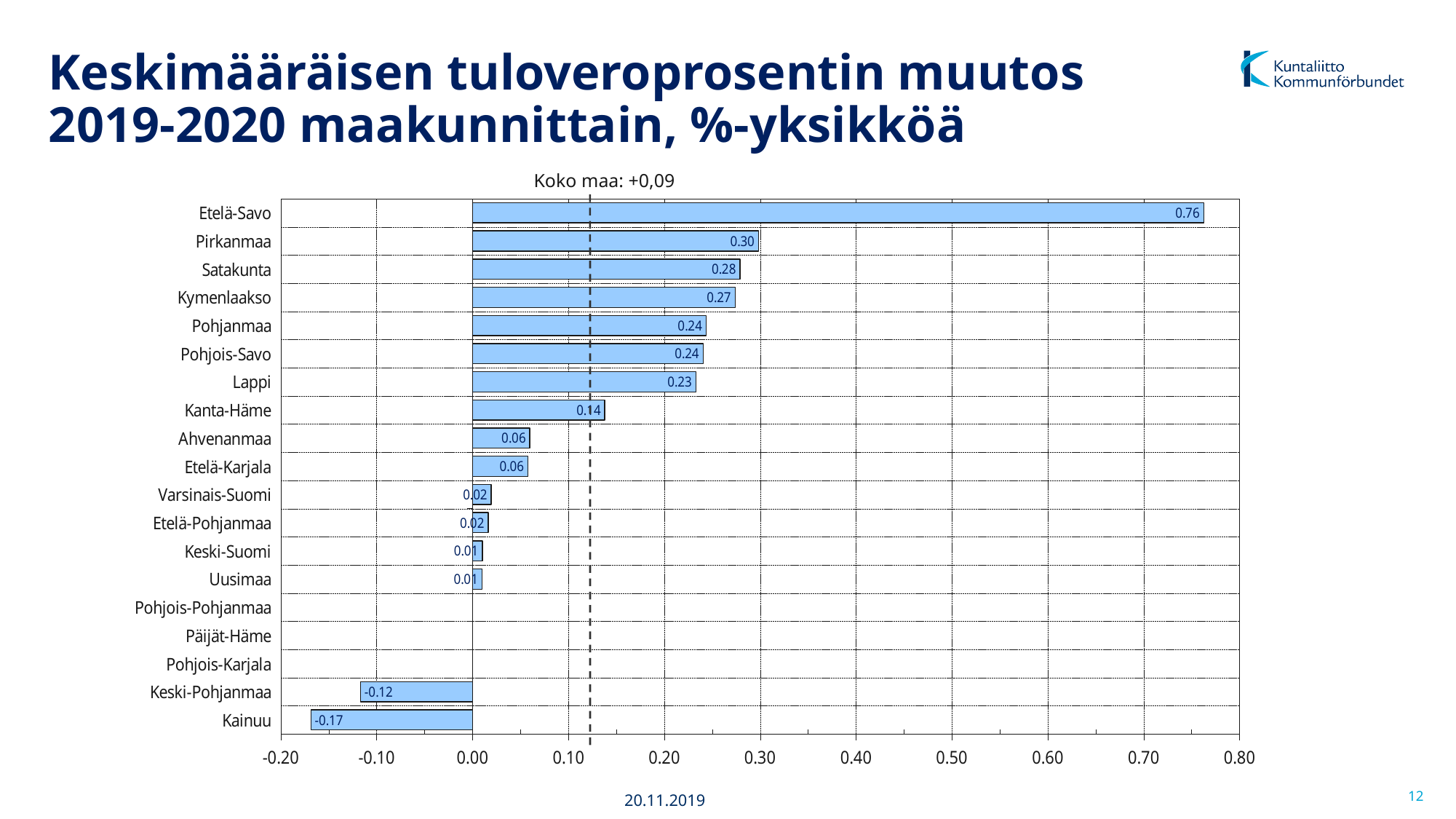
What is the value for Pirkanmaa? 0.30 What is the value for Kainuu? -0.17 What is the value for Keski-Pohjanmaa? -0.12 Is the value for Kymenlaakso greater or less than 0.20? greater What is the difference between the values for Etelä-Savo and Pirkanmaa? 0.46 Which region has the highest value? Etelä-Savo What kind of chart is shown on the slide? Bar chart What value for the whole country (Koko maa) is stated above the chart? +0,09 Which is larger, the value for Satakunta or the value for Lappi? Satakunta What is the value for Etelä-Savo? 0.76 How many regions are shown on the chart? 19 Which region has the lowest value? Kainuu